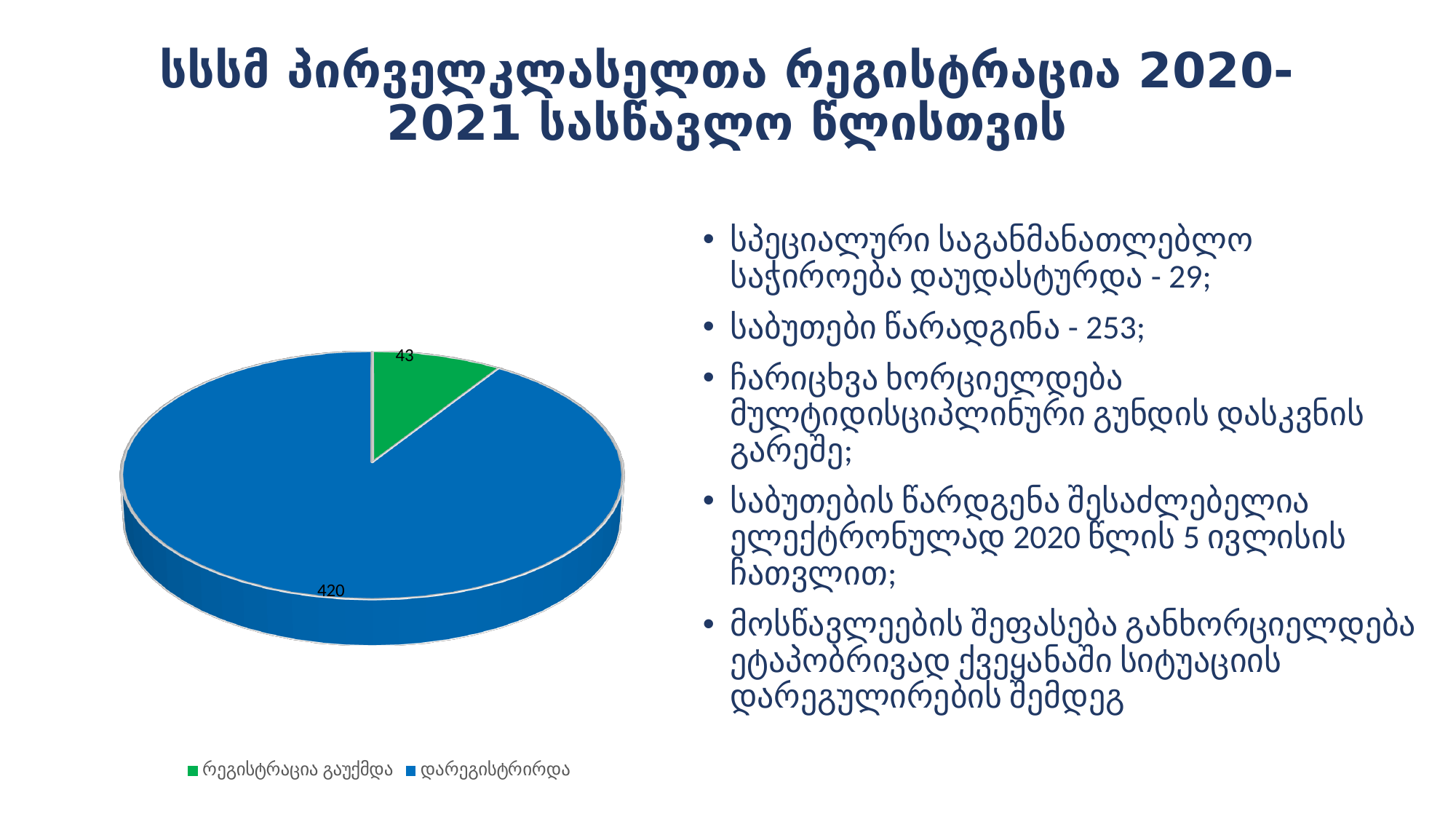
What is the total of the two values shown in the pie chart? 463 What type of chart is shown on the slide? pie chart Which category has the largest slice in the pie chart? დარეგისტრირდა How many slices does the pie chart have? 2 What colour is the slice for "რეგისტრაცია გაუქმდა"? green How many entries does the legend list? 2 What is the difference between the values for "დარეგისტრირდა" and "რეგისტრაცია გაუქმდა"? 377 What share of the pie does the "რეგისტრაცია გაუქმდა" slice represent, to one decimal place? 9.3% What is the value for the slice labelled "რეგისტრაცია გაუქმდა"? 43 Which category has the smallest slice in the pie chart? რეგისტრაცია გაუქმდა What is the value for the slice labelled "დარეგისტრირდა"? 420 Which is larger: the value for "დარეგისტრირდა" or the value for "რეგისტრაცია გაუქმდა"? დარეგისტრირდა